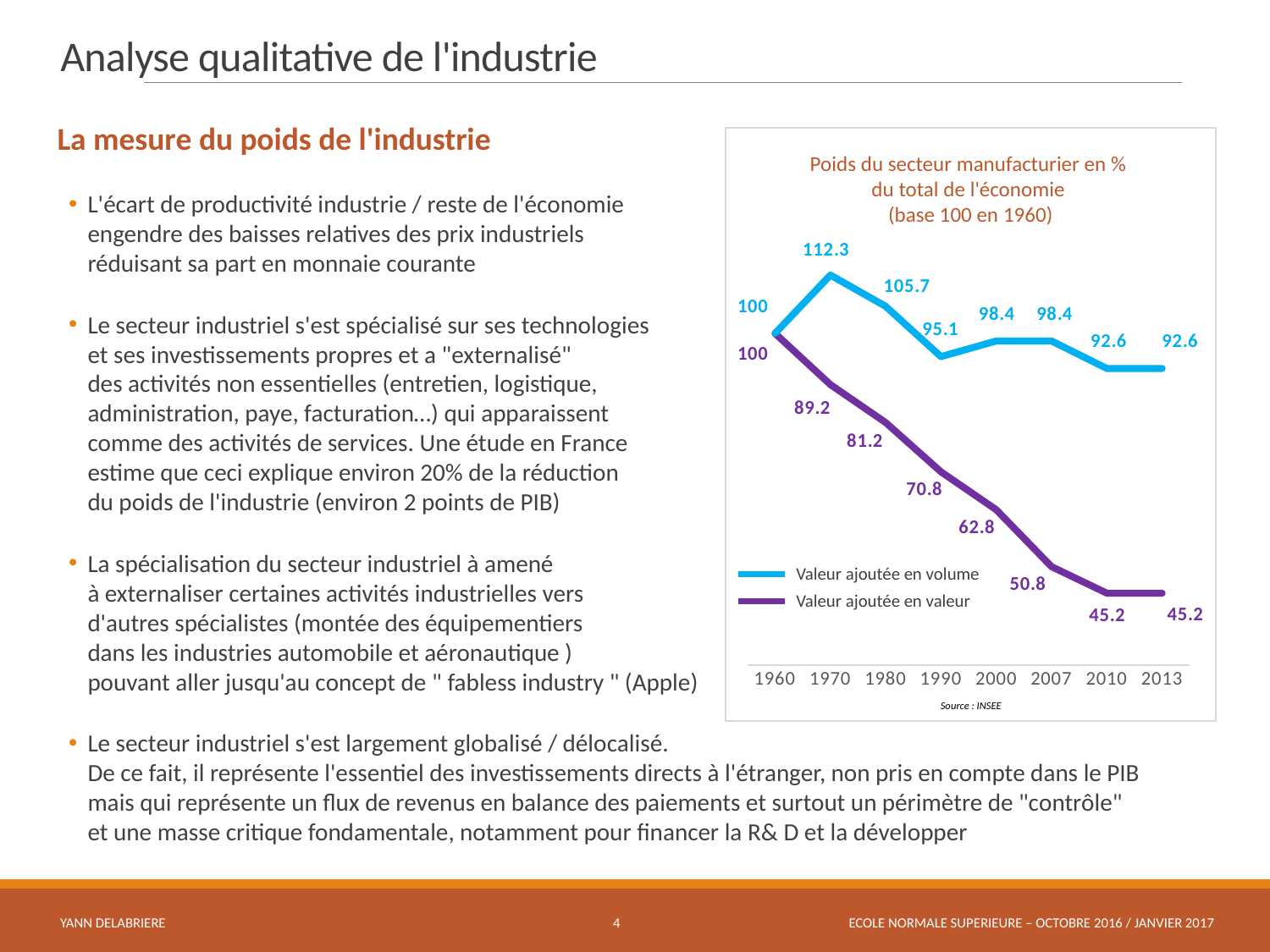
What is the value of 'Valeur ajoutée en valeur' in 2013? 45.2 What is the value of 'Valeur ajoutée en valeur' in 2007? 50.8 What is the value of 'Valeur ajoutée en volume' in 1970? 112.3 What is the difference between 'Valeur ajoutée en volume' and 'Valeur ajoutée en valeur' in 2013? 47.4 How many series does the chart legend list? 2 How many years are shown on the x axis of the chart? 8 Does 'Valeur ajoutée en valeur' rise or fall from 1960 to 2013? fall What kind of chart is shown on the slide? line chart What is the title of the chart? Poids du secteur manufacturier en % du total de l'économie (base 100 en 1960) What is the lowest value shown for 'Valeur ajoutée en valeur'? 45.2 Which series has the higher value in 1990, 'Valeur ajoutée en volume' or 'Valeur ajoutée en valeur'? Valeur ajoutée en volume In which year does 'Valeur ajoutée en volume' reach its highest value? 1970